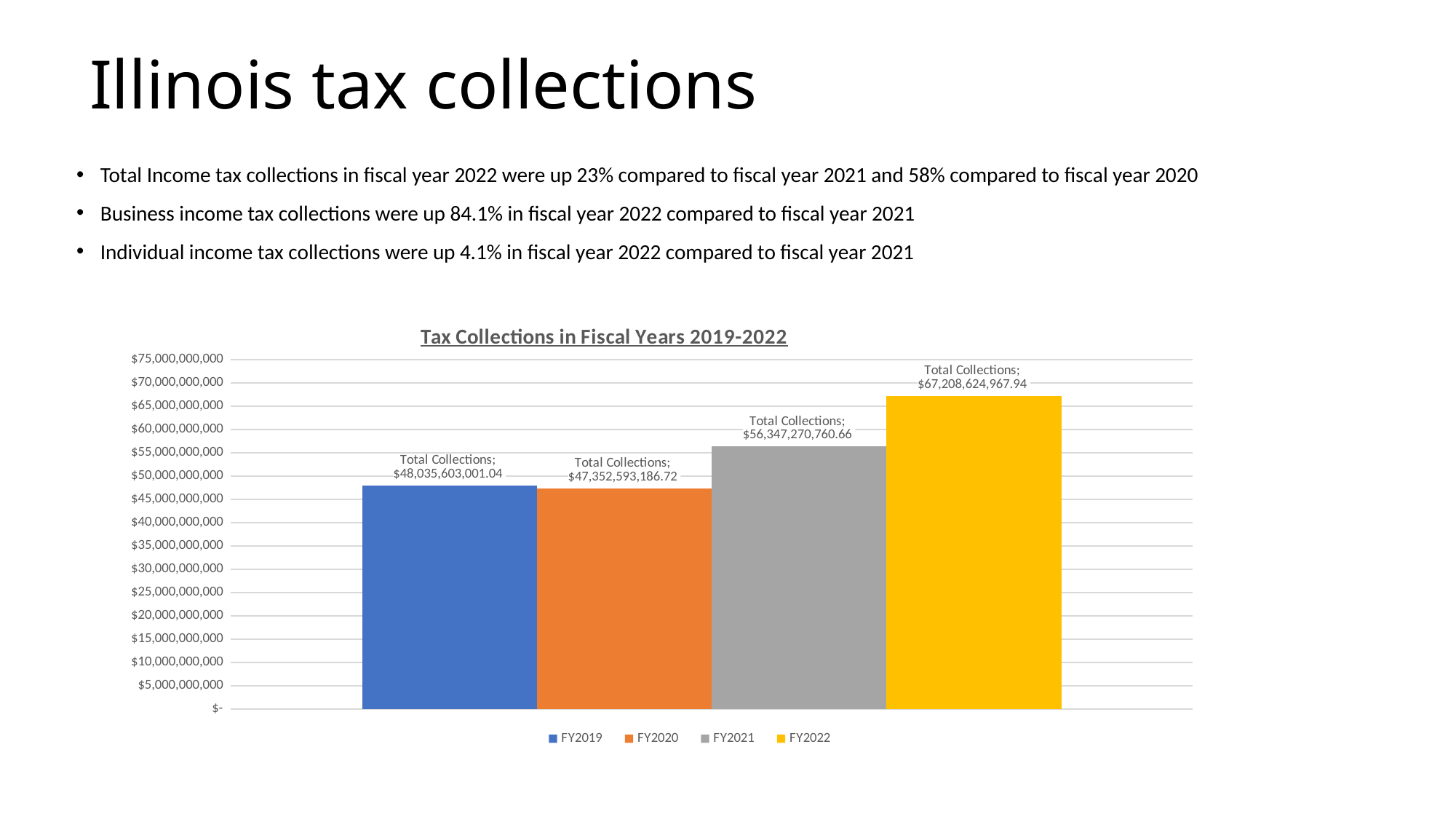
What is the value of Total Collections for FY2021? $56,347,270,760.66 What is the value of Total Collections for FY2019? $48,035,603,001.04 What is the value of Total Collections for FY2022? $67,208,624,967.94 Which fiscal year has the lowest total collections? FY2020 What is the difference between total collections in FY2022 and FY2021? $10,861,354,207.28 What type of chart is shown on the slide? bar chart What is the title of the chart? Tax Collections in Fiscal Years 2019-2022 Which fiscal year has the highest total collections? FY2022 Is the value for FY2021 greater or less than $55,000,000,000? greater Do total collections rise or fall from FY2020 to FY2022? rise Which is larger, total collections in FY2019 or FY2020? FY2019 How many series does the legend list? 4